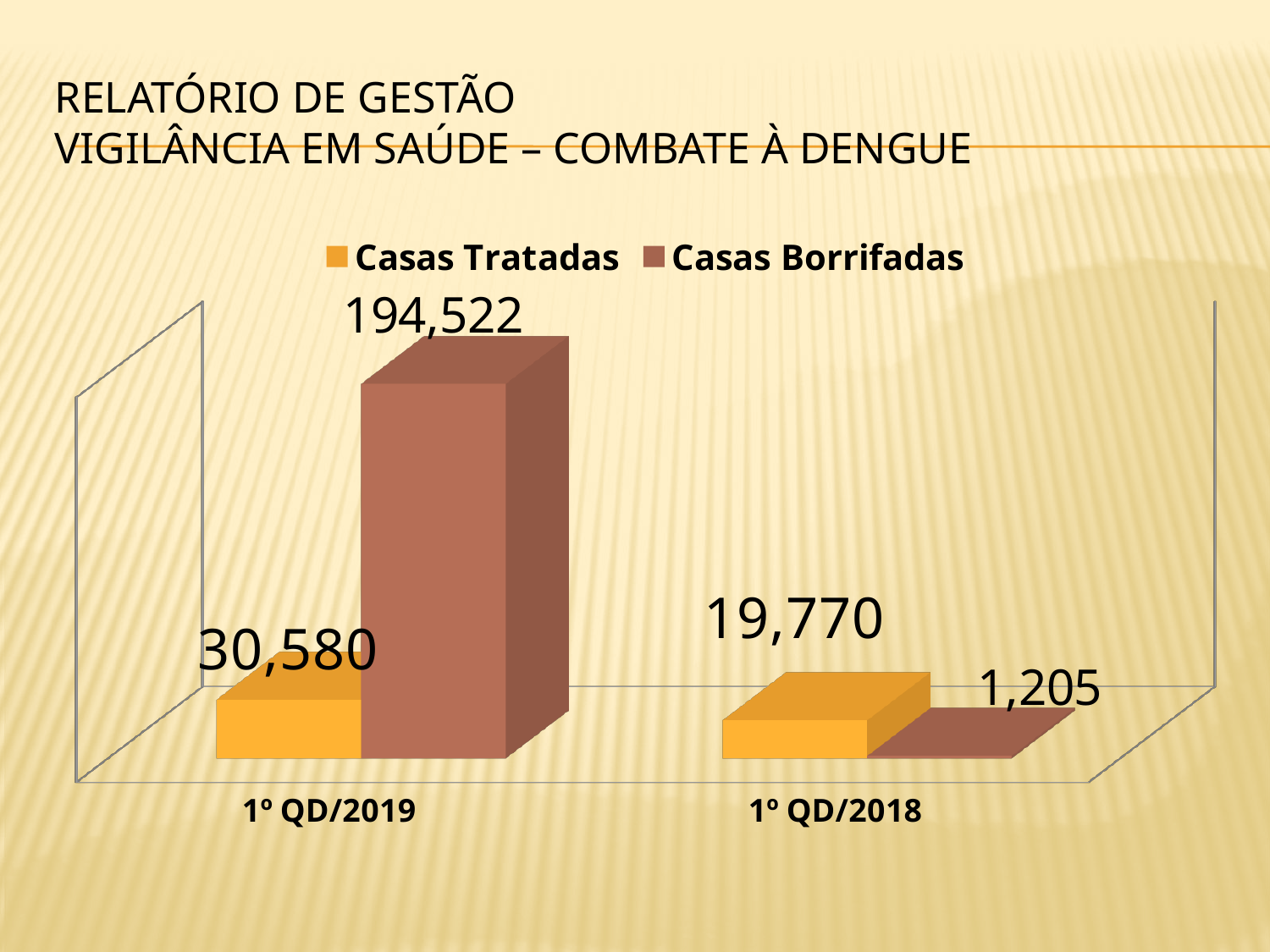
What is the difference between Casas Borrifadas and Casas Tratadas for 1º QD/2019? 163,942 Which is larger for 1º QD/2018: Casas Tratadas or Casas Borrifadas? Casas Tratadas What is the value of Casas Borrifadas for 1º QD/2019? 194,522 What is the value of Casas Tratadas for 1º QD/2018? 19,770 How many series does the legend list? 2 Which bar has the highest value in the chart? Casas Borrifadas, 1º QD/2019 Which bar has the lowest value in the chart? Casas Borrifadas, 1º QD/2018 What kind of chart is shown on the slide? Bar chart How many categories are shown on the x axis? 2 What is the value of Casas Tratadas for 1º QD/2019? 30,580 What is the value of Casas Borrifadas for 1º QD/2018? 1,205 What is the difference in Casas Tratadas between 1º QD/2019 and 1º QD/2018? 10,810